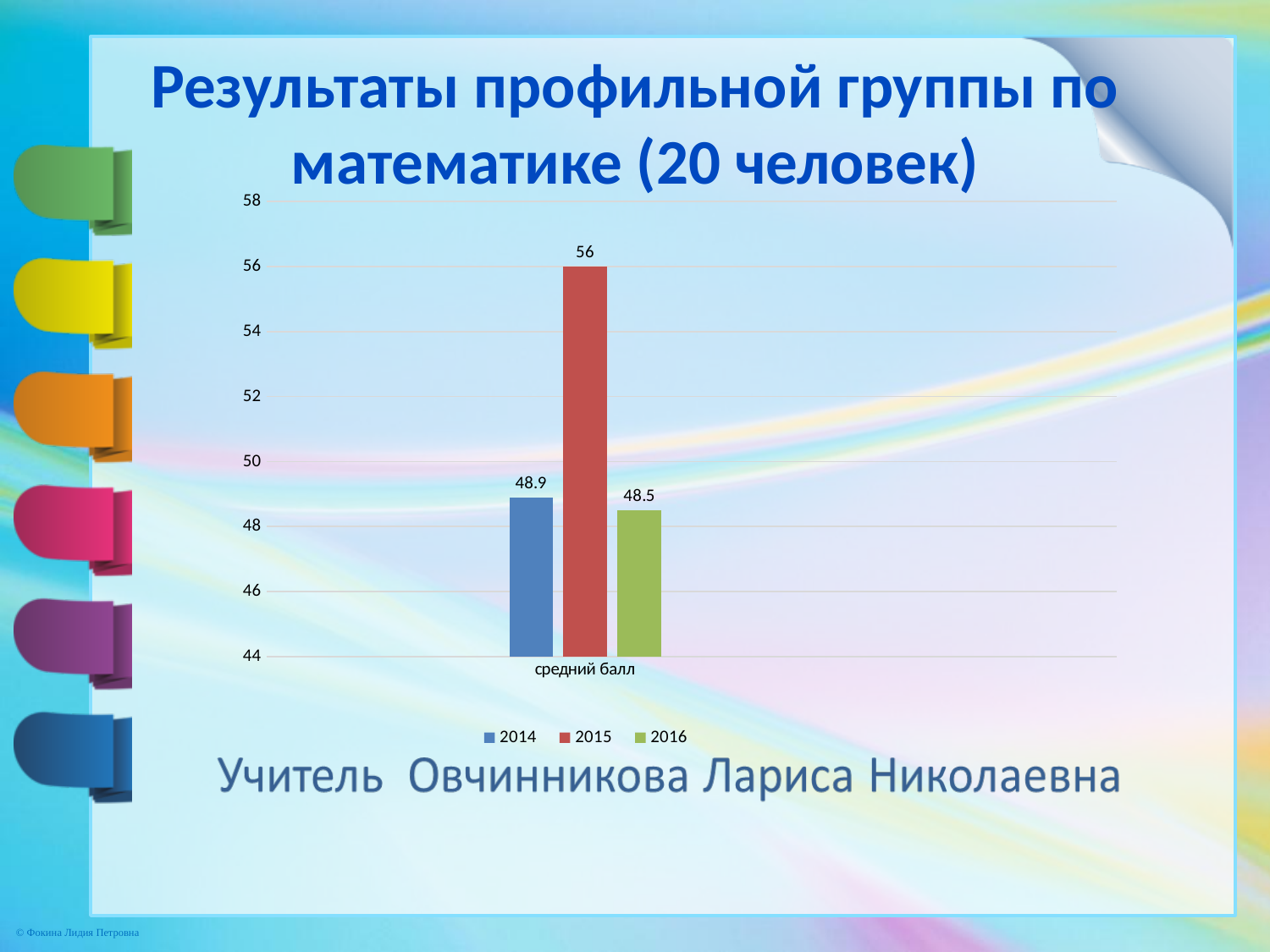
How many series does the legend list? 3 What is the difference between the values for 2015 and 2014? 7.1 What kind of chart is shown on the slide? bar chart What is the value for 2015 in the chart? 56 Which is larger, the value for 2015 or the value for 2016? 2015 Which year has the highest average score? 2015 What is the category label on the x axis of the chart? средний балл Which year has the lowest average score? 2016 What is the difference between the values for 2014 and 2016? 0.4 What is the value for 2016 in the chart? 48.5 Is the value for 2015 greater or less than 54? greater What is the value for 2014 in the chart? 48.9